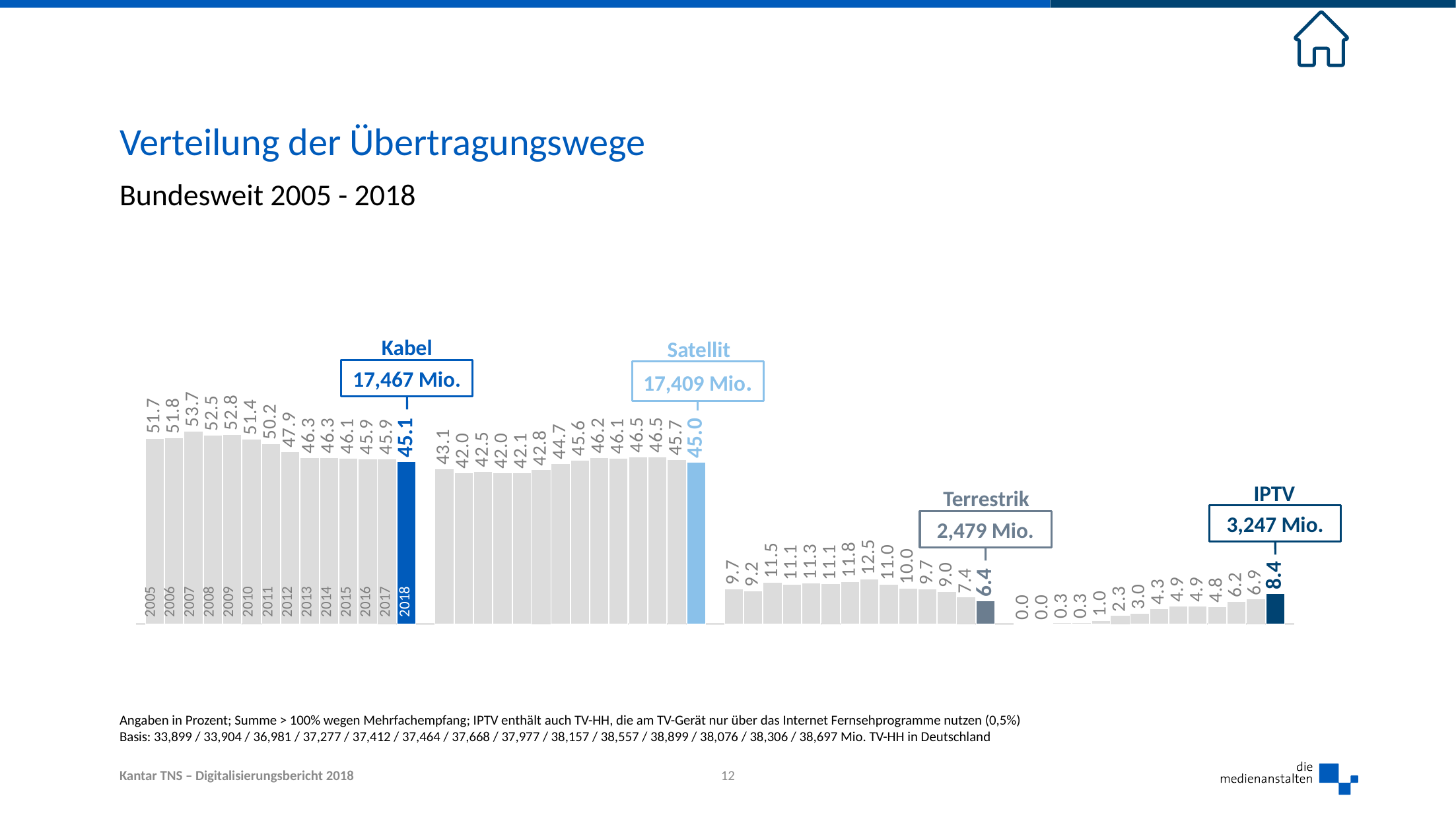
What is the highest value shown for Terrestrik? 12.5 What is the value for Kabel in 2018? 45.1 What number of households (Mio.) is shown in the box above the Satellit bars? 17,409 Mio. What is the value for Kabel in 2005? 51.7 What is the value for IPTV in 2018? 8.4 What is the difference between the Kabel value in 2005 and in 2018? 6.6 How many years are shown for each transmission path? 14 Do the IPTV values rise or fall from 2005 to 2018? rise What kind of chart is shown on the slide? bar chart Which is larger in 2018, Terrestrik or IPTV? IPTV In which year does Kabel reach its highest value? 2007 What is the value for Satellit in 2018? 45.0